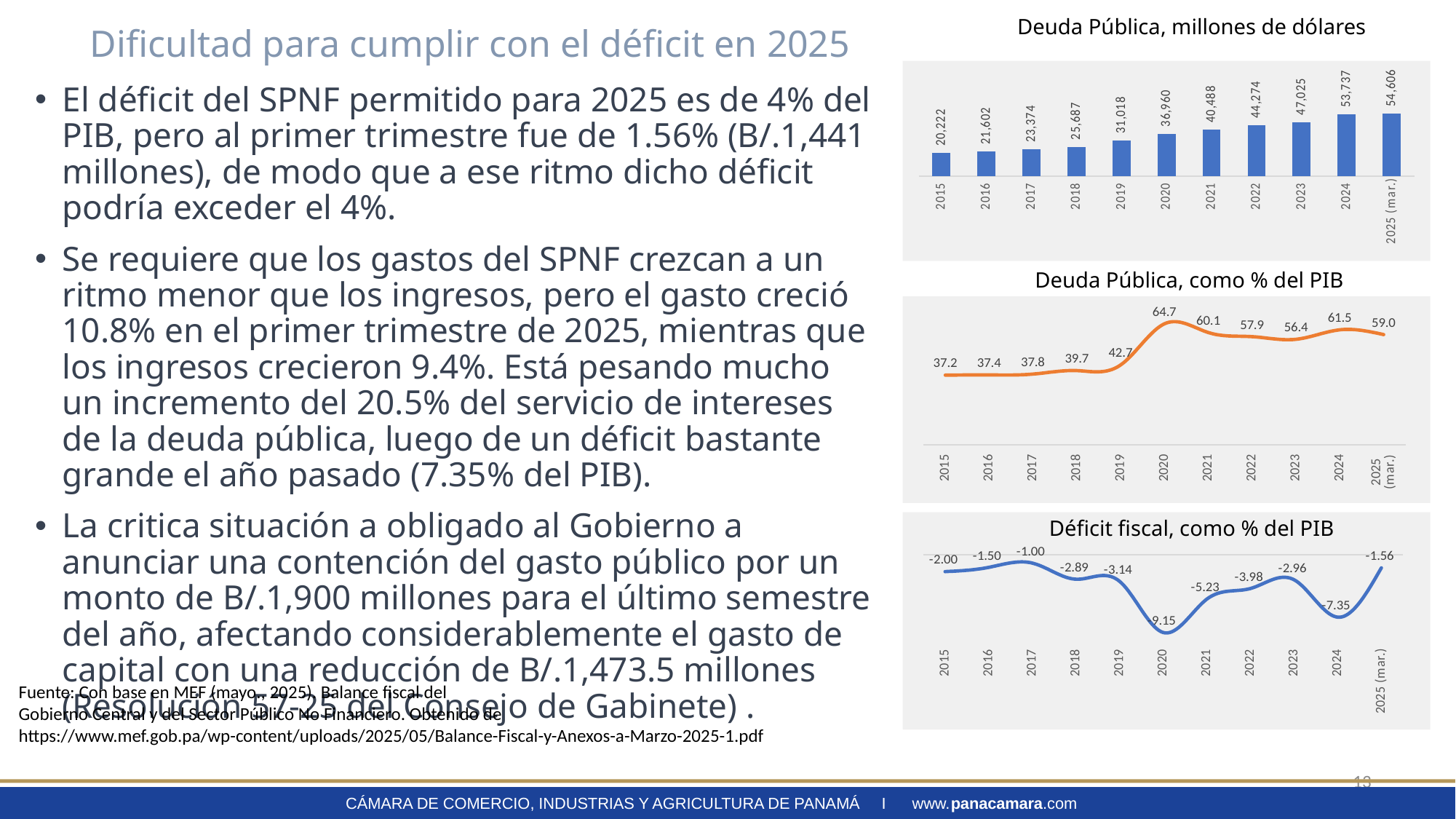
In the chart 'Deuda Pública, como % del PIB', which year has the lowest value? 2015 What kind of chart is 'Deuda Pública, millones de dólares'? bar chart How many years are plotted in the chart 'Deuda Pública, como % del PIB'? 11 In the chart 'Deuda Pública, millones de dólares', what is the value for 2019? 31,018 In the chart 'Déficit fiscal, como % del PIB', what is the value for 2025 (mar.)? -1.56 In the chart 'Déficit fiscal, como % del PIB', what is the value for 2020? -9.15 In the chart 'Deuda Pública, millones de dólares', do the values rise or fall from 2015 to 2025 (mar.)? rise In the chart 'Deuda Pública, como % del PIB', what is the value for 2020? 64.7 What kind of chart is 'Déficit fiscal, como % del PIB'? line chart In the chart 'Deuda Pública, millones de dólares', what is the difference between the 2024 and 2023 values? 6,712 In the chart 'Deuda Pública, millones de dólares', which year has the highest value? 2025 (mar.) In the chart 'Deuda Pública, como % del PIB', which is larger, the value for 2024 or the value for 2023? 2024